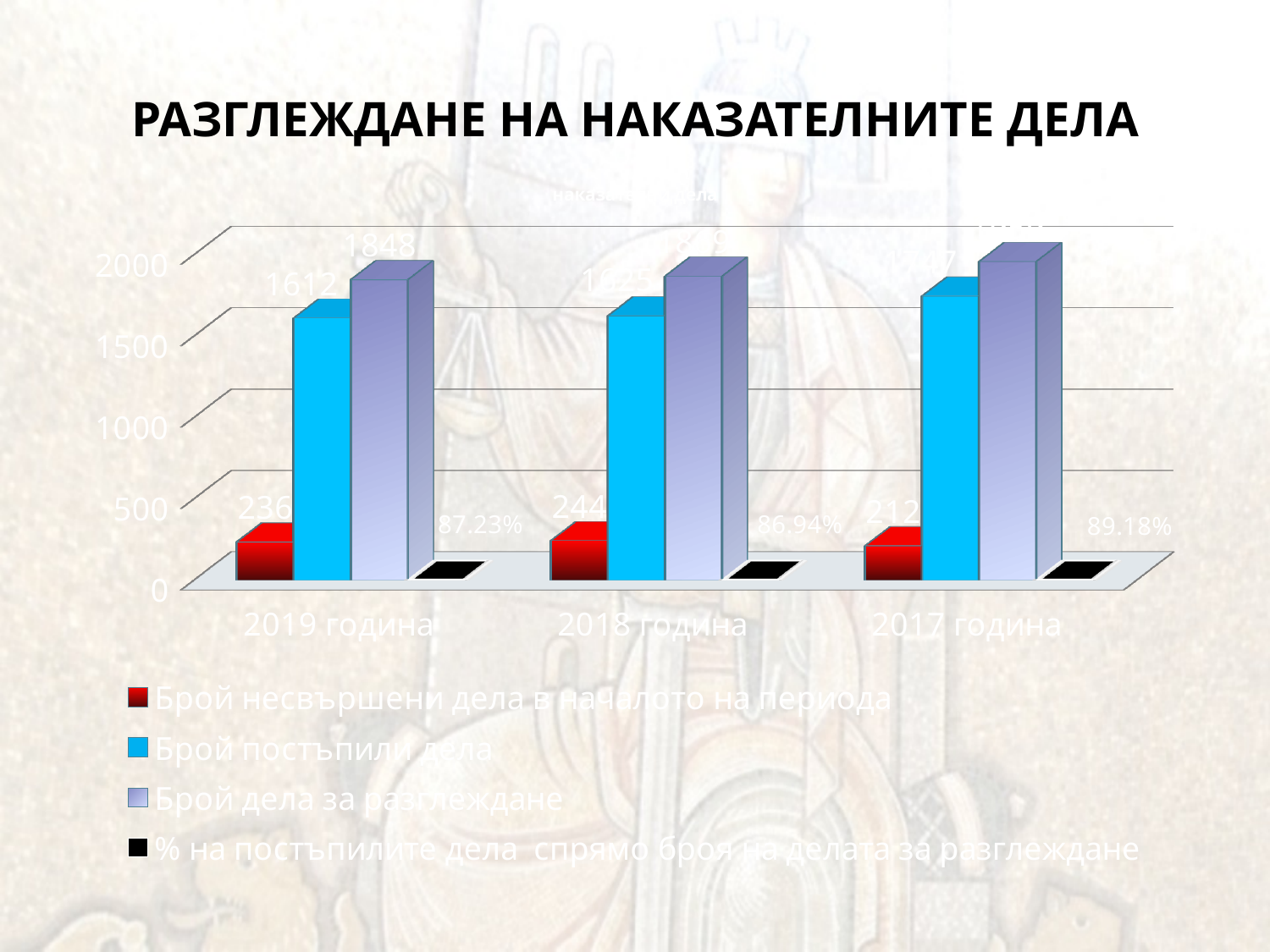
How many series does the legend list? 4 What is the value of Брой постъпили дела for 2019 година? 1612 Which is larger: Брой несвършени дела в началото на периода for 2018 година or for 2019 година? 2018 година What is the percentage shown for 2019 година for the series % на постъпилите дела спрямо броя на делата за разглеждане? 87.23% What is the value of Брой несвършени дела в началото на периода for 2017 година? 212 What is the value of Брой дела за разглеждане for 2019 година? 1848 What is the difference between Брой дела за разглеждане and Брой постъпили дела for 2019 година? 236 Is the value of Брой постъпили дела for 2017 година greater or less than 1500? greater What kind of chart is shown on the slide? bar chart Which year has the highest value for % на постъпилите дела спрямо броя на делата за разглеждане? 2017 година Which year has the lowest value for Брой несвършени дела в началото на периода? 2017 година What is the value of Брой несвършени дела в началото на периода for 2018 година? 244